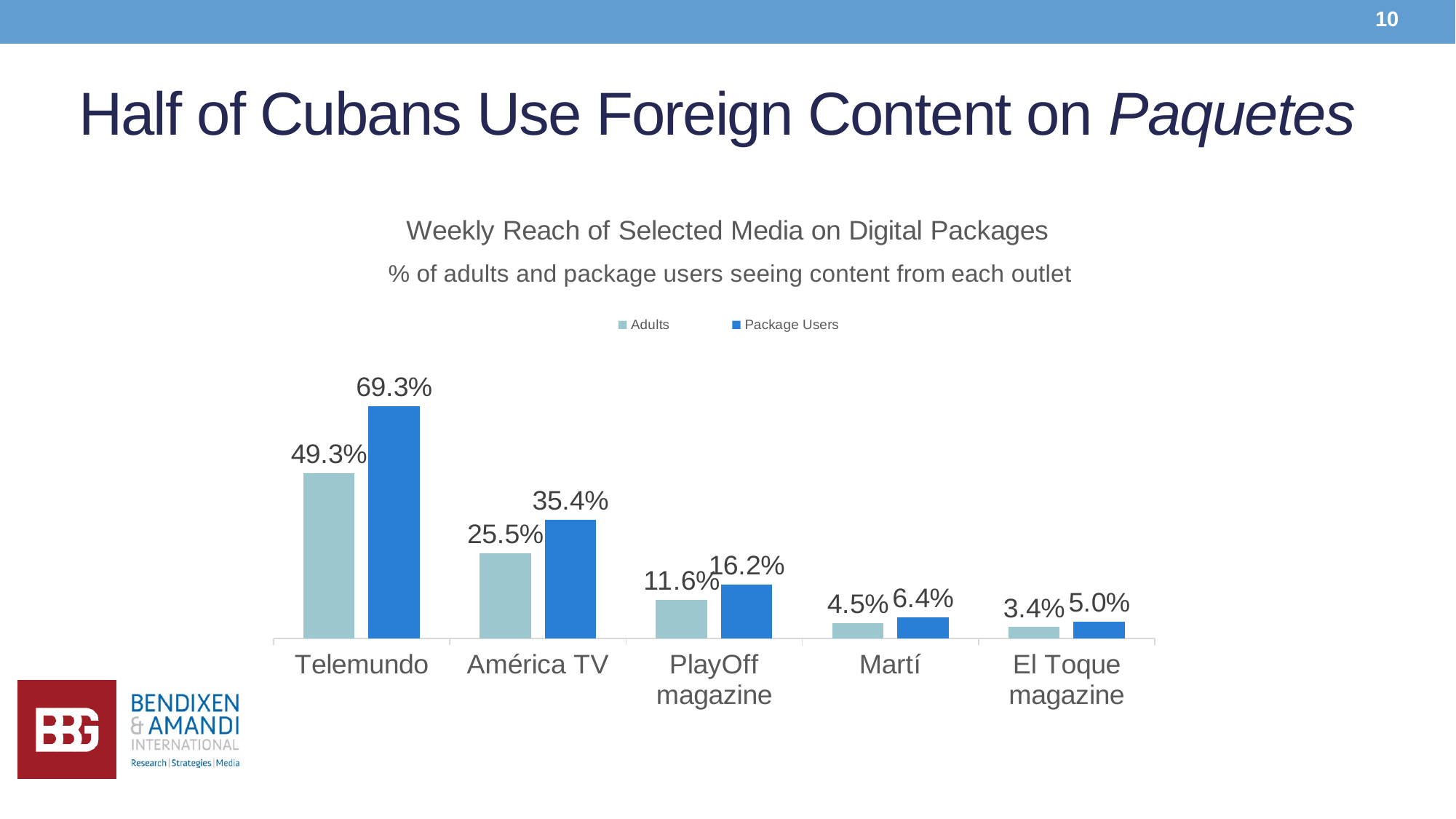
What is the title of the chart? Weekly Reach of Selected Media on Digital Packages What is the Package Users value for Telemundo? 69.3% What is the Adults value for América TV? 25.5% What is the Adults value for PlayOff magazine? 11.6% What kind of chart is shown on the slide? Bar chart How many outlets are shown on the x axis? 5 What is the difference between the Package Users and Adults values for Telemundo? 20.0% How many series does the legend list? 2 Which outlet has the highest Package Users value? Telemundo Which outlet has the lowest Adults value? El Toque magazine What is the Package Users value for El Toque magazine? 5.0% Which is larger: the Adults value for América TV or the Package Users value for PlayOff magazine? Adults value for América TV